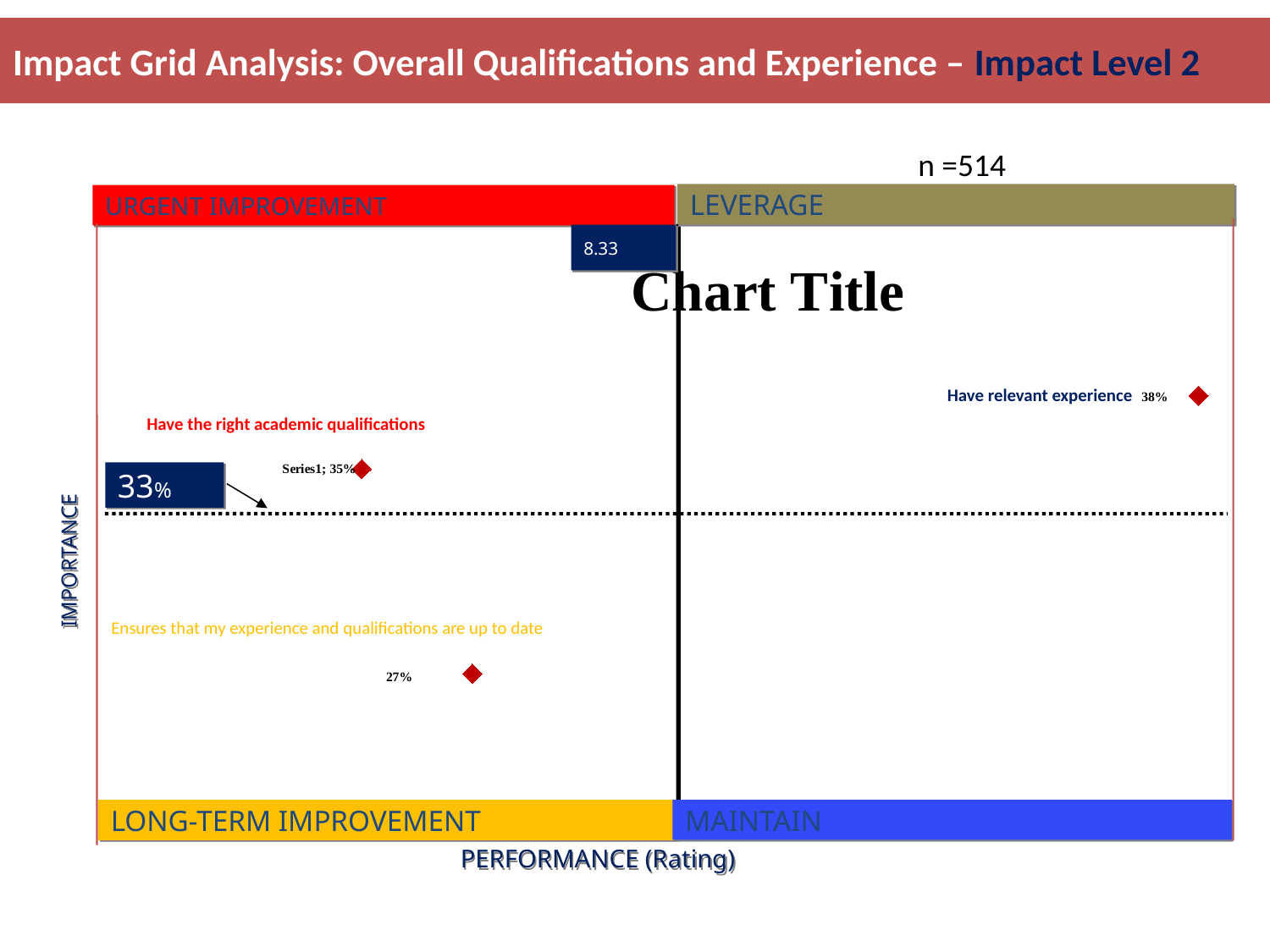
Which item has the lowest value on the chart? Ensures that my experience and qualifications are up to date What is the label of the horizontal axis of the chart? PERFORMANCE (Rating) What is the value shown for "Have relevant experience"? 38% Which is larger: the value for "Have relevant experience" or the value for "Have the right academic qualifications"? Have relevant experience Which item has the highest value on the chart? Have relevant experience How many data points are plotted on the chart? 3 Which quadrant does the "Have relevant experience" point fall in? LEVERAGE What kind of chart is shown on the slide? Scatter chart What is the value shown next to the "Have the right academic qualifications" point? 35% What is the value shown for "Ensures that my experience and qualifications are up to date"? 27% What is the difference between the values for "Have relevant experience" and "Ensures that my experience and qualifications are up to date"? 11 percentage points